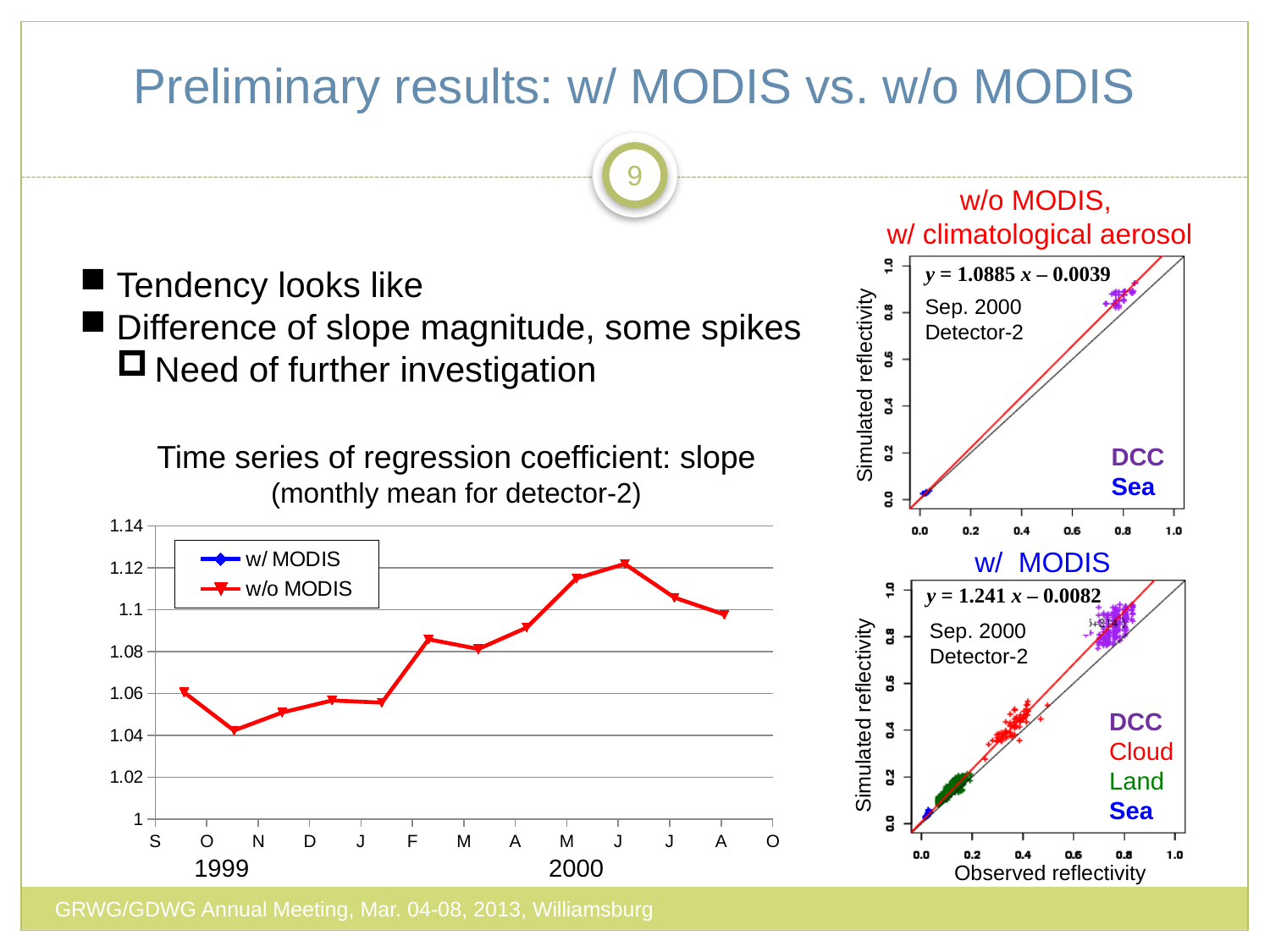
In the 'Time series of regression coefficient: slope' chart, is the w/o MODIS value for February 2000 greater or less than 1.08? greater In the 'Time series of regression coefficient: slope' chart, is the w/o MODIS value for October 1999 greater or less than 1.06? less In the 'Time series of regression coefficient: slope' chart, does the w/o MODIS slope generally rise or fall from September 1999 to June 2000? rise In the 'Time series of regression coefficient: slope' chart, how many monthly points are plotted for the w/o MODIS series? 12 In the 'Time series of regression coefficient: slope' chart, in which month is the w/o MODIS slope lowest? October 1999 In the 'Time series of regression coefficient: slope' chart, in which month is the w/o MODIS slope highest? June 2000 In the 'Time series of regression coefficient: slope' chart, which has the larger w/o MODIS slope, January 2000 or February 2000? February 2000 In the 'Time series of regression coefficient: slope' chart, what are the two legend entries? w/ MODIS and w/o MODIS In the 'Time series of regression coefficient: slope' chart, how many series does the legend list? 2 In the 'Time series of regression coefficient: slope' chart, is the w/o MODIS value for June 2000 greater or less than 1.1? greater In the 'w/ MODIS' scatter plot on the right, what regression equation is printed? y = 1.241 x − 0.0082 In the 'Time series of regression coefficient: slope' chart, what kind of chart is it? line chart